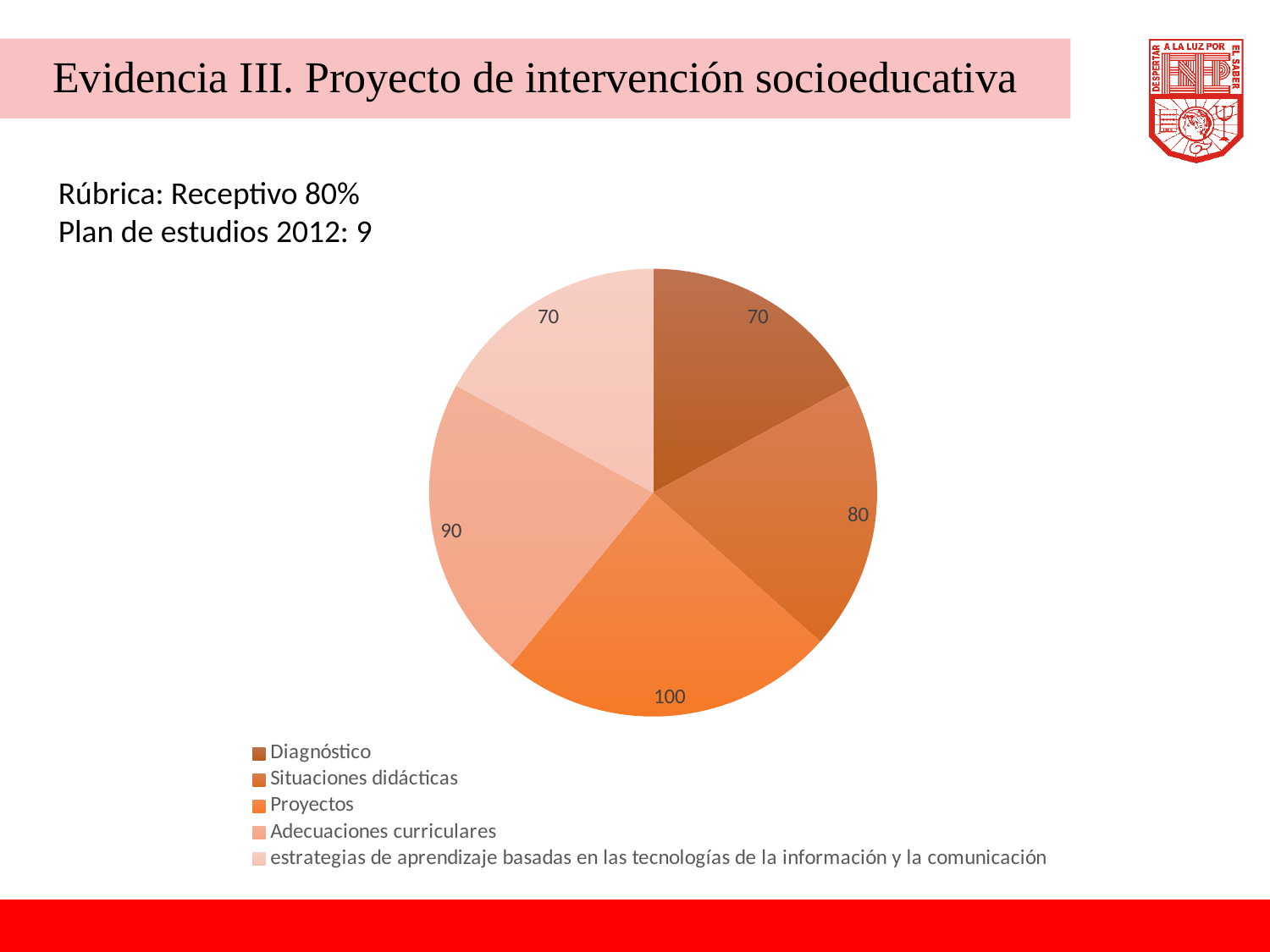
What kind of chart is shown on the slide? pie chart Which legend entry is shown with the lightest colour in the pie chart? estrategias de aprendizaje basadas en las tecnologías de la información y la comunicación What is the value for Situaciones didácticas in the pie chart? 80 What is the sum of all the values shown in the pie chart? 410 Which category has the largest slice in the pie chart? Proyectos What is the value for Proyectos in the pie chart? 100 What is the value for Diagnóstico in the pie chart? 70 Which is larger, the value for Adecuaciones curriculares or the value for Situaciones didácticas? Adecuaciones curriculares How many slices does the pie chart have? 5 What is the difference between the values for Proyectos and Diagnóstico? 30 What is the difference between the values for Adecuaciones curriculares and Situaciones didácticas? 10 What is the value for Adecuaciones curriculares in the pie chart? 90